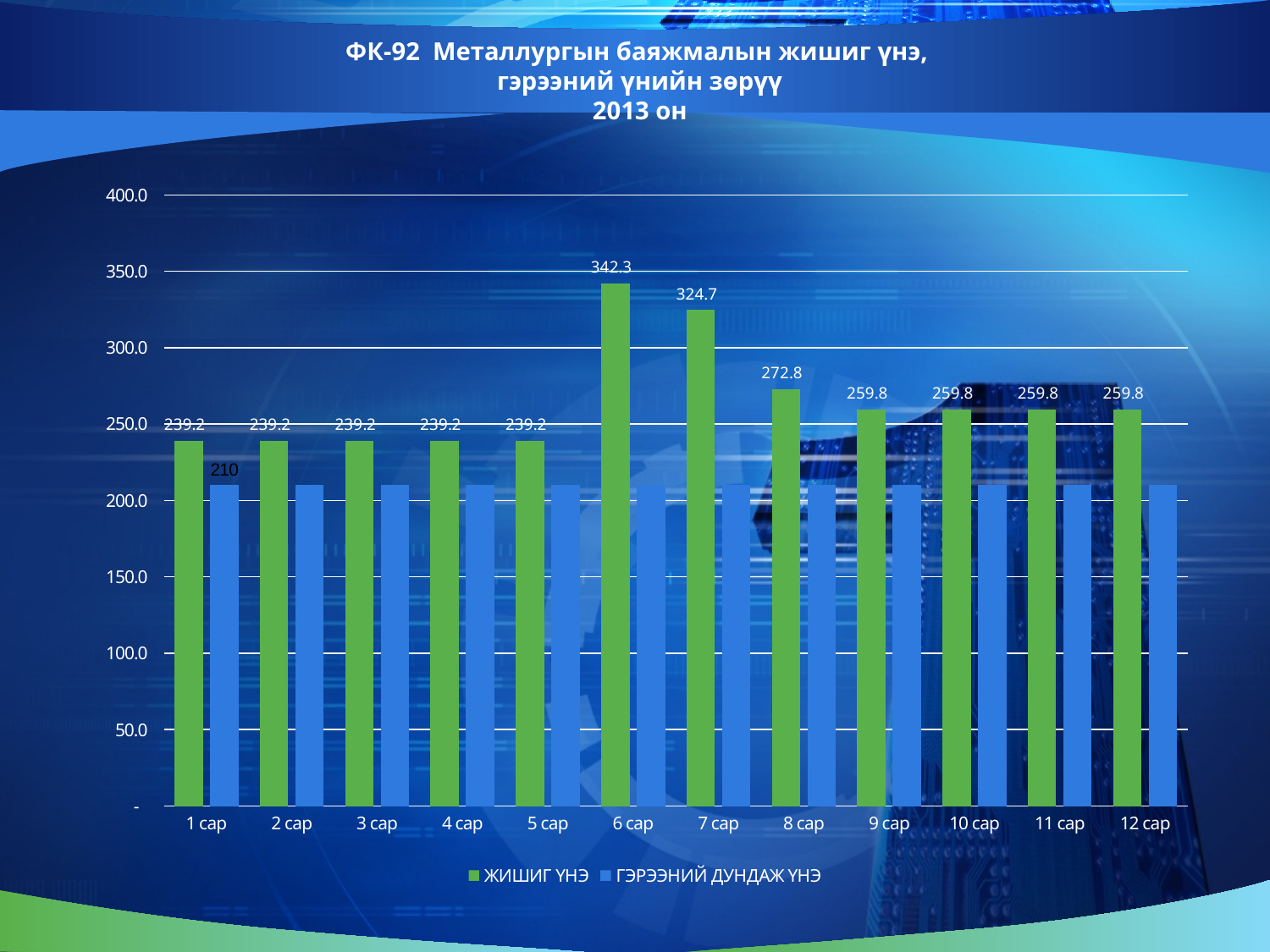
How many months (categories) are shown on the x axis? 12 What is the difference between the ЖИШИГ ҮНЭ values for 6 сар and 7 сар? 17.6 What is the ГЭРЭЭНИЙ ДУНДАЖ ҮНЭ value for 1 сар? 210 Which is larger, the ЖИШИГ ҮНЭ value for 7 сар or for 9 сар? 7 сар What is the ЖИШИГ ҮНЭ value for 8 сар? 272.8 What is the difference between the ЖИШИГ ҮНЭ and ГЭРЭЭНИЙ ДУНДАЖ ҮНЭ values for 1 сар? 29.2 Which series is shown in green in the legend? ЖИШИГ ҮНЭ What is the ЖИШИГ ҮНЭ value for 6 сар? 342.3 Is the ГЭРЭЭНИЙ ДУНДАЖ ҮНЭ value for 6 сар greater or less than 250.0? less How many series does the legend list? 2 What type of chart is shown on the slide? bar chart Which month has the highest ЖИШИГ ҮНЭ value? 6 сар